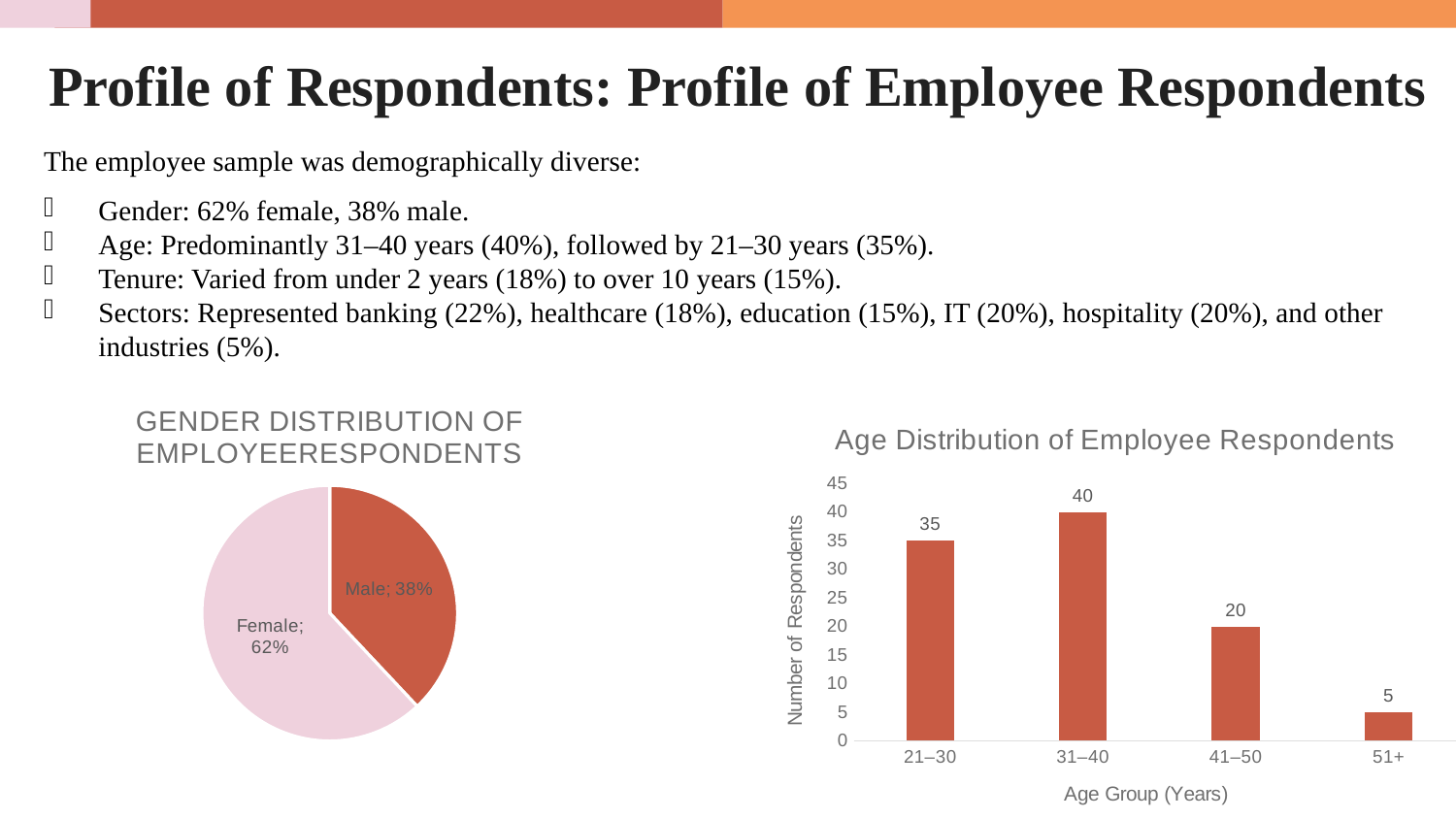
In the Age Distribution of Employee Respondents chart, do the values rise or fall from 31–40 to 51+? fall How many age groups are shown in the Age Distribution of Employee Respondents chart? 4 What kind of chart is the Age Distribution of Employee Respondents chart? bar chart In the Age Distribution of Employee Respondents chart, what is the value for the 51+ age group? 5 What is the y-axis label of the Age Distribution of Employee Respondents chart? Number of Respondents In the Age Distribution of Employee Respondents chart, which age group has the highest number of respondents? 31–40 In the Age Distribution of Employee Respondents chart, which age group has the lowest number of respondents? 51+ In the Age Distribution of Employee Respondents chart, which is larger, the value for 21–30 or the value for 41–50? 21–30 In the Age Distribution of Employee Respondents chart, what is the value for the 31–40 age group? 40 In the Gender Distribution of Employee Respondents pie chart, what share is Female? 62% What kind of chart is the Gender Distribution of Employee Respondents chart? pie chart In the Age Distribution of Employee Respondents chart, what is the difference between the values for 21–30 and 41–50? 15